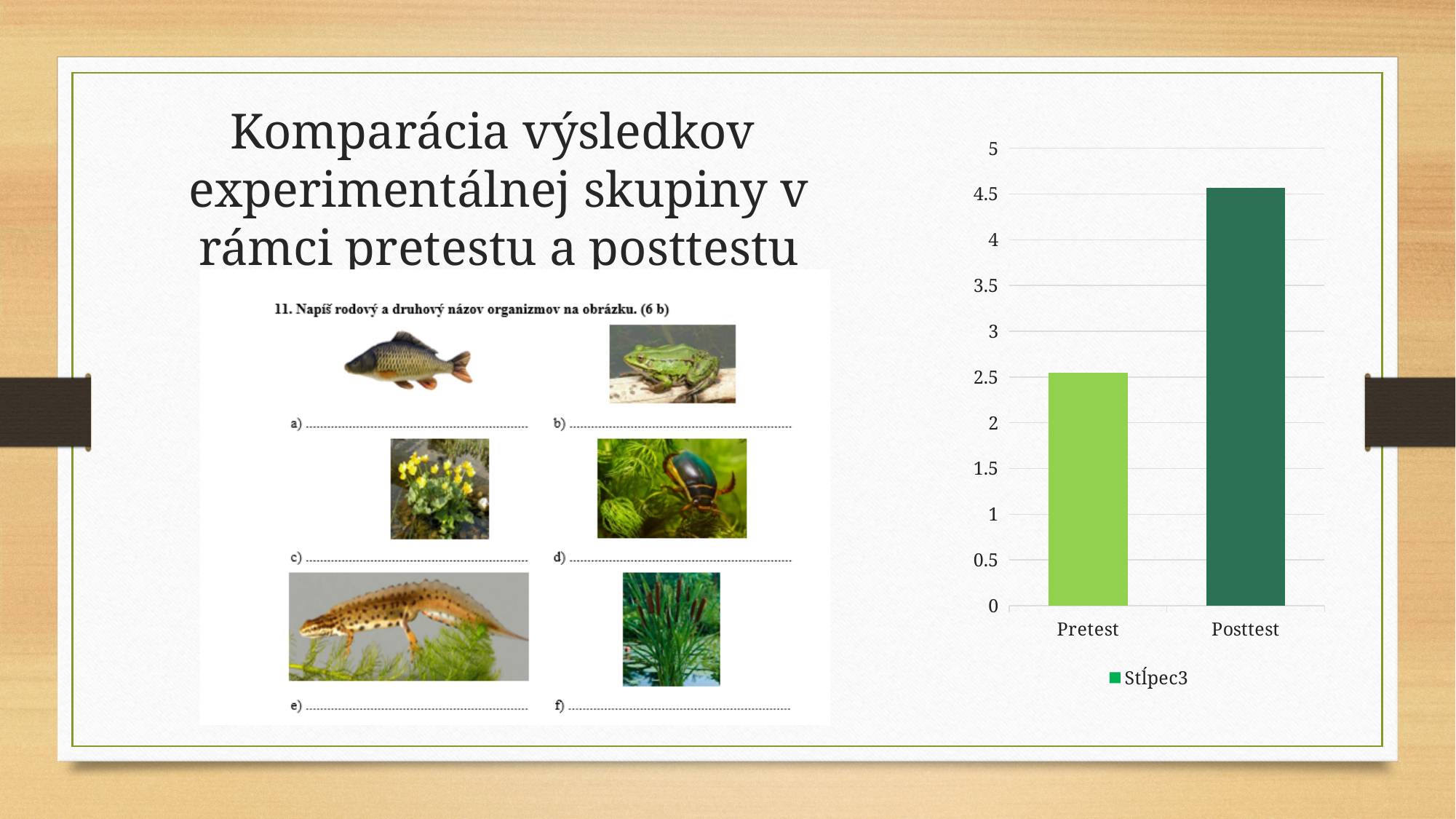
Is the value for Posttest greater or less than 4? greater How many series does the chart legend list? 1 Is the value for Pretest greater or less than 2? greater Is the value for Posttest greater or less than 5? less What kind of chart is shown on the slide? bar chart Which category has the lowest value in the chart? Pretest Which is larger, the value for Pretest or the value for Posttest? Posttest What is the name of the series shown in the chart legend? Stĺpec3 Do the values rise or fall from Pretest to Posttest? rise How many categories are plotted on the x axis of the chart? 2 Which category has the highest value in the chart? Posttest